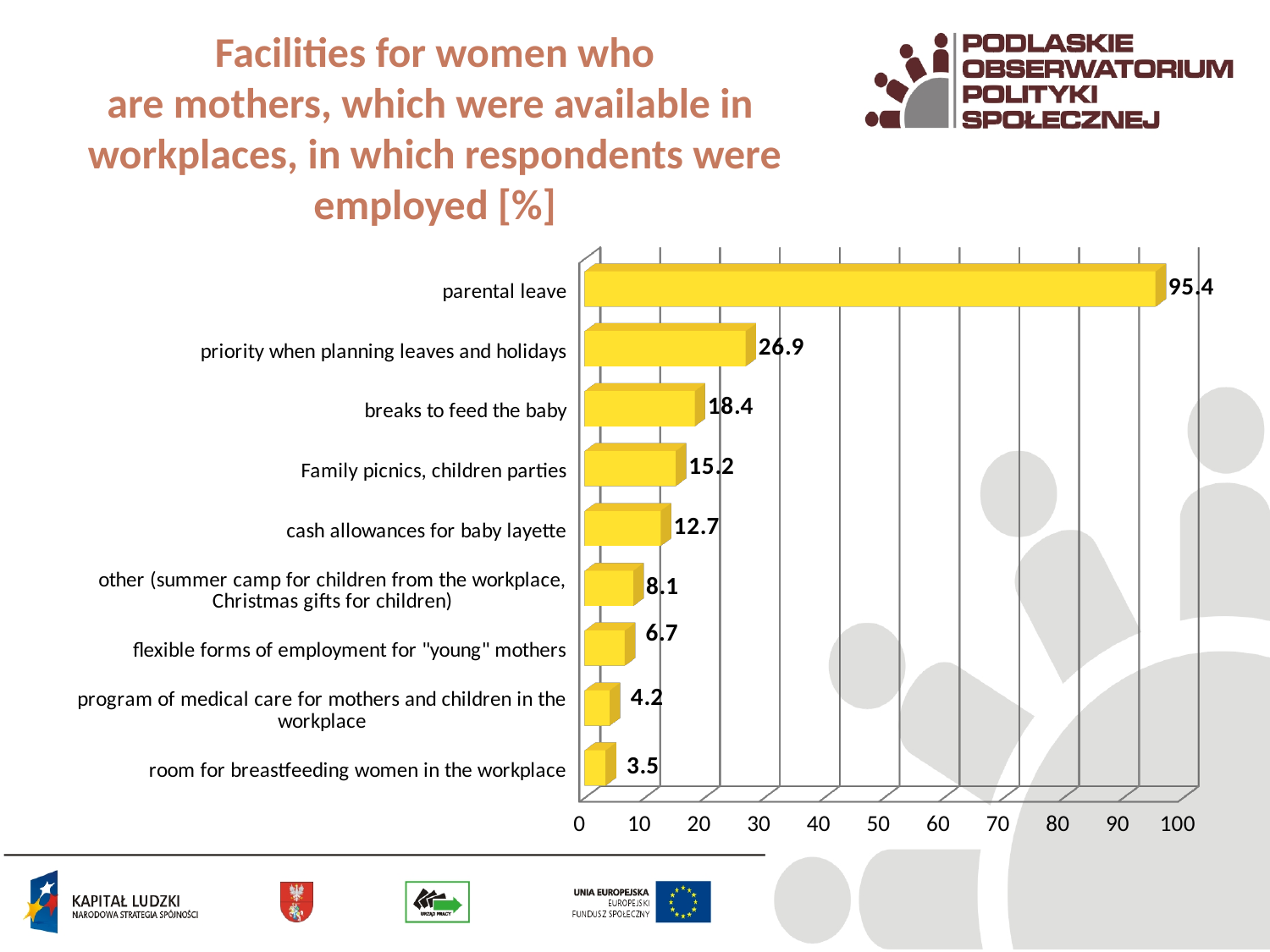
What is the value for breaks to feed the baby? 18.4 What is the value for flexible forms of employment for "young" mothers? 6.7 What kind of chart is shown on the slide? bar chart What is the maximum value shown on the horizontal axis? 100 Which category has the highest value? parental leave Which is larger: the value for Family picnics, children parties or the value for cash allowances for baby layette? Family picnics, children parties Is the value for priority when planning leaves and holidays greater or less than 30? less What is the value for parental leave? 95.4 Which category has the lowest value? room for breastfeeding women in the workplace What is the value for room for breastfeeding women in the workplace? 3.5 How many categories are shown in the chart? 9 What is the difference between the values for priority when planning leaves and holidays and breaks to feed the baby? 8.5